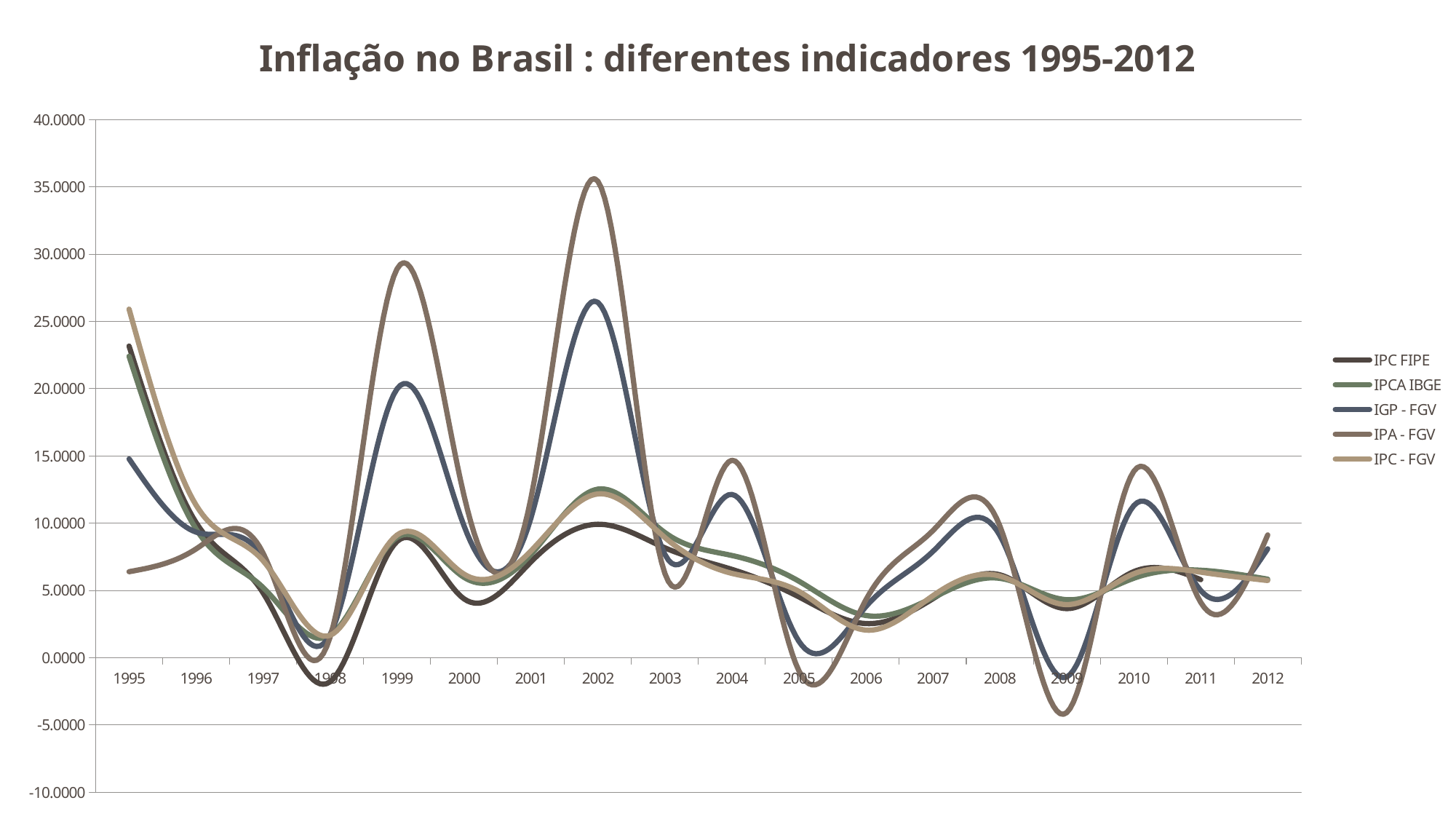
Which series is listed first in the legend? IPC FIPE In which year does the IPA - FGV series reach its highest value? 2002 How many series does the legend list? 5 What kind of chart is shown on the slide? line chart In 2002, which series has the higher value, IPA - FGV or IGP - FGV? IPA - FGV Is the value for IPA - FGV in 2009 greater or less than 0? less Is the value for IGP - FGV in 1995 greater or less than 20? less Does the IPC FIPE series rise or fall from 1995 to 1998? fall What is the title of the chart? Inflação no Brasil : diferentes indicadores 1995-2012 Is the value for IPA - FGV in 1999 greater or less than 25? greater How many years are shown along the x axis? 18